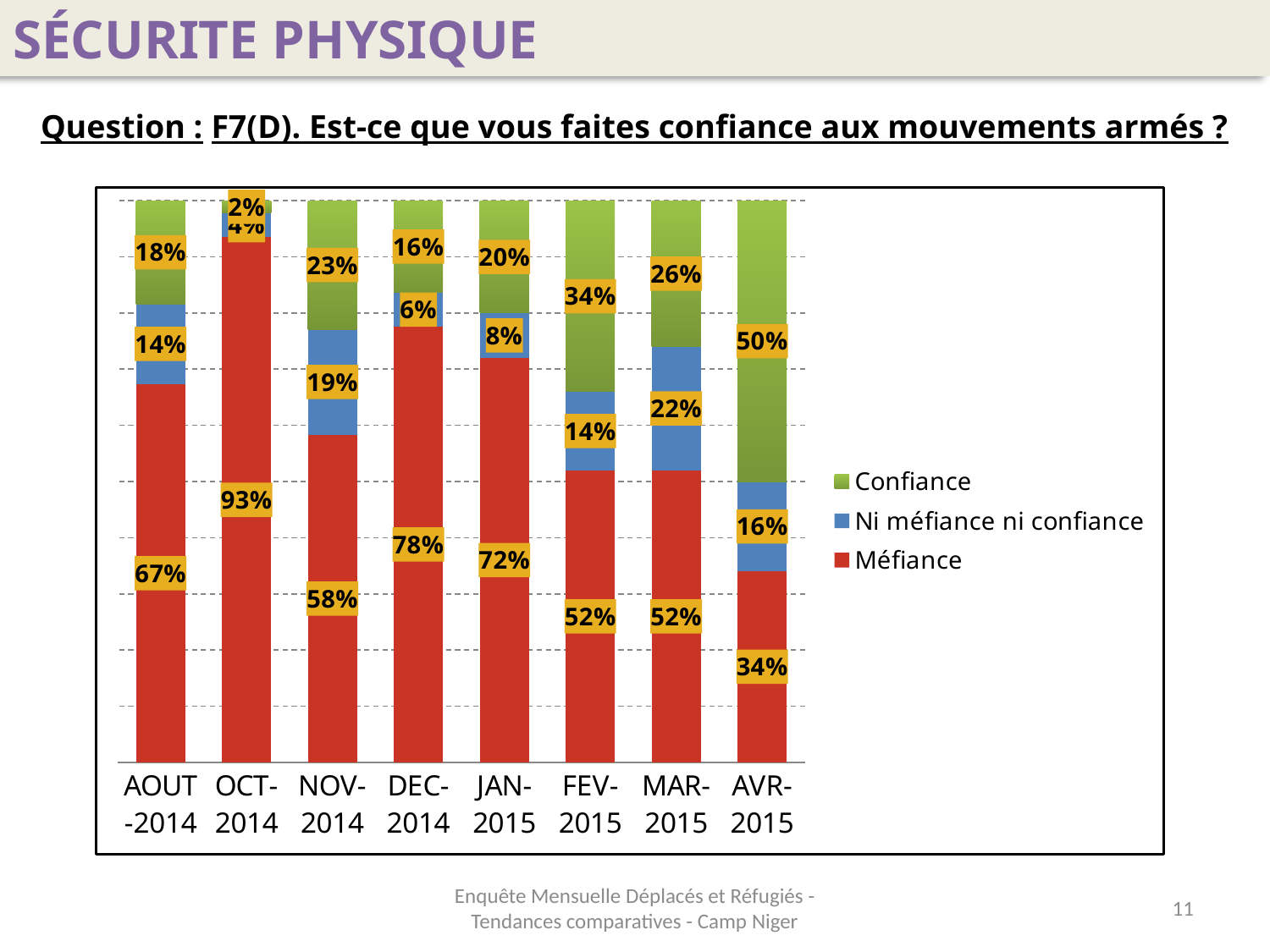
How many months are shown on the x axis? 8 In which month is the Méfiance share the highest? OCT-2014 How many series does the legend list? 3 Which colour represents Méfiance in the legend? Red Which month has the larger Ni méfiance ni confiance value, NOV-2014 or MAR-2015? MAR-2015 What is the difference between the Confiance values for FEV-2015 and MAR-2015? 8 percentage points What is the Ni méfiance ni confiance value for JAN-2015? 8% What is the Confiance value for AVR-2015? 50% Does the Méfiance value rise or fall from DEC-2014 to AVR-2015? Fall What is the Méfiance value for AOUT-2014? 67% What kind of chart is shown on the slide? Stacked bar chart In which month is the Méfiance share the lowest? AVR-2015